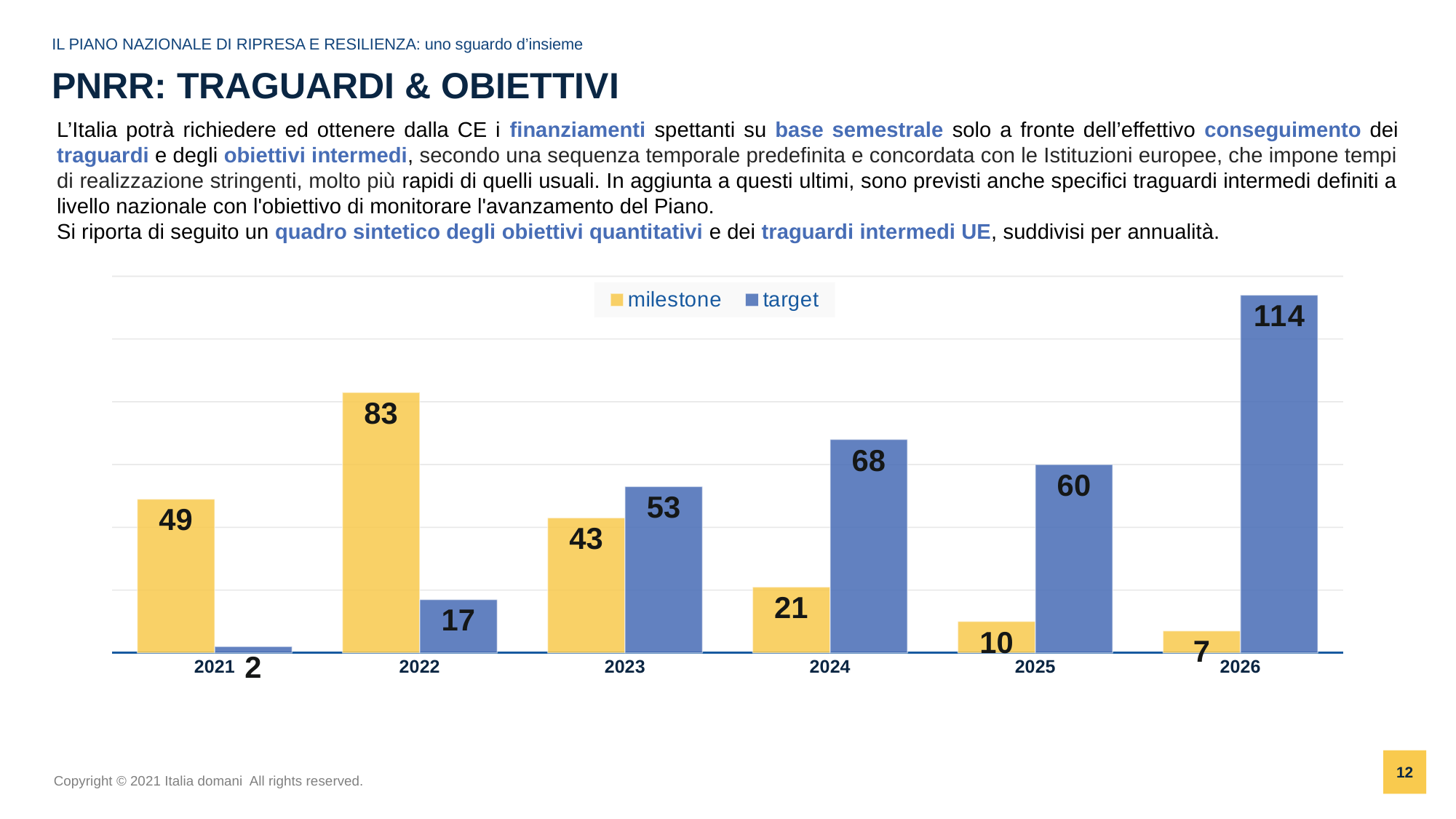
How many series does the legend list? 2 Which year has the highest target value? 2026 Which year has the lowest milestone value? 2026 What is the difference between the target and milestone values in 2024? 47 What kind of chart is shown on the slide? bar chart What is the target value for 2021? 2 In 2023, which is larger, the milestone value or the target value? target Do the milestone values rise or fall from 2022 to 2026? fall What is the milestone value for 2022? 83 What is the target value for 2026? 114 How many years are shown on the x axis? 6 Which colour represents the target series in the legend? blue